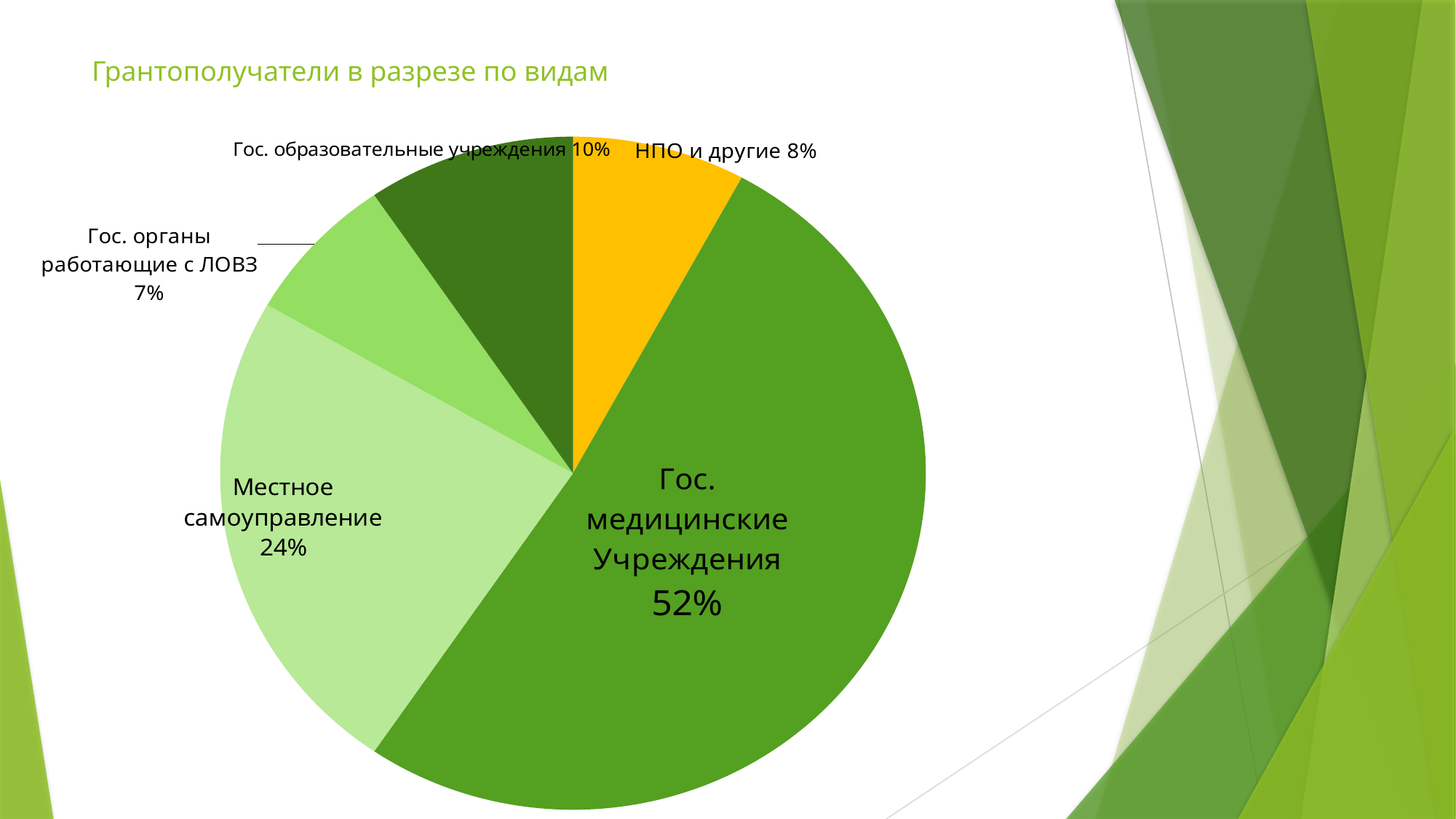
What is the title of the chart on the slide? Грантополучатели в разрезе по видам Which category has the largest slice of the pie? Гос. медицинские Учреждения What share of the pie does Местное самоуправление hold? 24% What share of the pie does Гос. медицинские Учреждения hold? 52% Which is larger: Гос. образовательные учреждения or НПО и другие? Гос. образовательные учреждения What kind of chart is shown on the slide? Pie chart How many categories are shown in the pie chart? 5 What is the difference in percentage points between Гос. медицинские Учреждения and Местное самоуправление? 28 What is the value shown for Гос. органы работающие с ЛОВЗ? 7% What is the value shown for Гос. образовательные учреждения? 10% What is the value shown for НПО и другие? 8% Which category has the smallest slice of the pie? Гос. органы работающие с ЛОВЗ